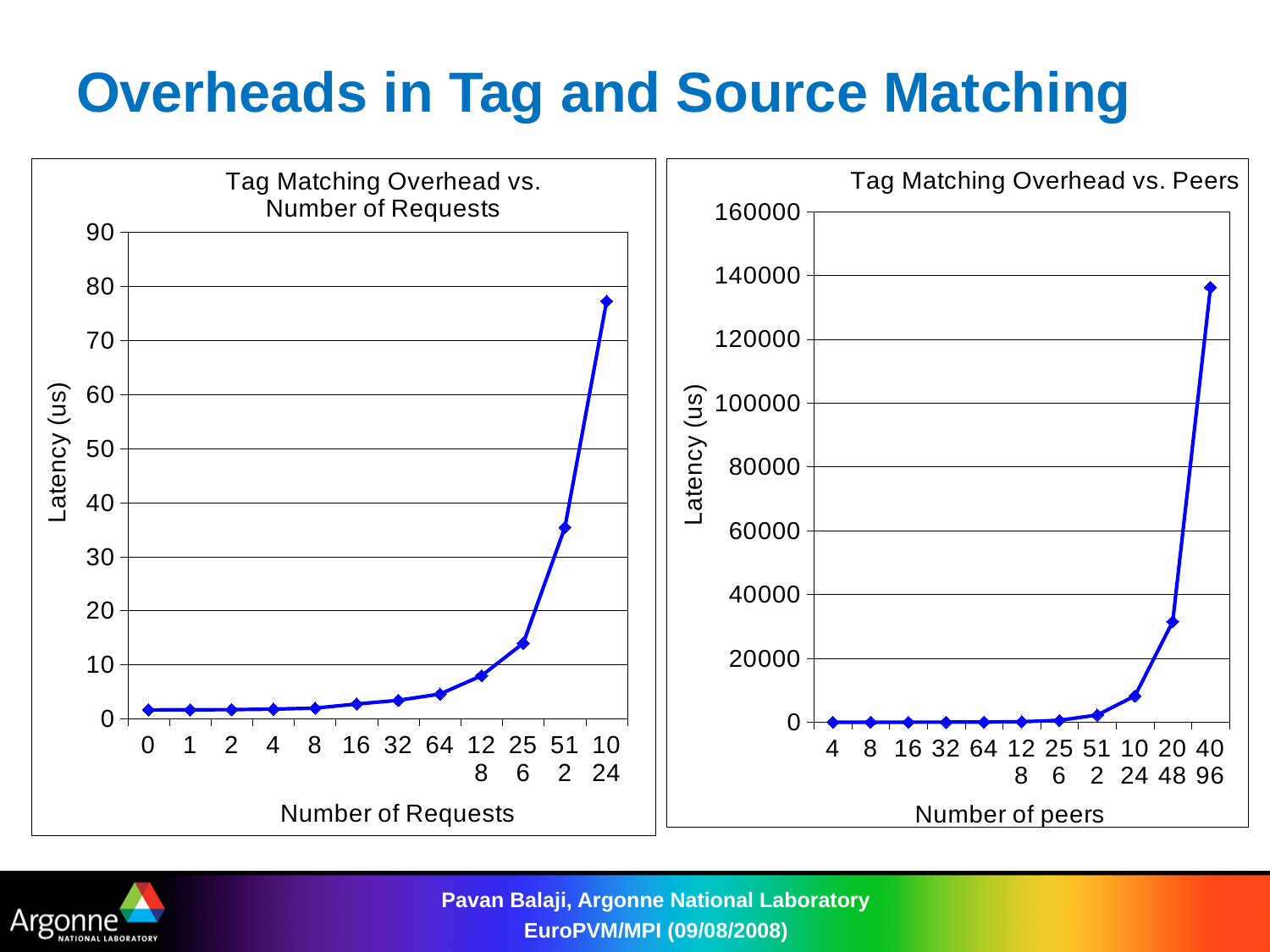
In the 'Tag Matching Overhead vs. Number of Requests' chart, how many data points are plotted? 12 In the 'Tag Matching Overhead vs. Peers' chart, does latency rise or fall as the number of peers increases? rise In the 'Tag Matching Overhead vs. Peers' chart, which number of peers has the highest latency? 4096 In the 'Tag Matching Overhead vs. Peers' chart, is the latency for 2048 peers greater or less than 40000? less In the 'Tag Matching Overhead vs. Number of Requests' chart, is the latency for 512 requests greater or less than 30? greater In the 'Tag Matching Overhead vs. Number of Requests' chart, which number of requests has the highest latency? 1024 In the 'Tag Matching Overhead vs. Peers' chart, is the latency for 4096 peers greater or less than 120000? greater In the 'Tag Matching Overhead vs. Peers' chart, how many data points are plotted? 11 What kind of chart is the 'Tag Matching Overhead vs. Number of Requests' chart? line chart What is the y-axis label of the 'Tag Matching Overhead vs. Peers' chart? Latency (us)